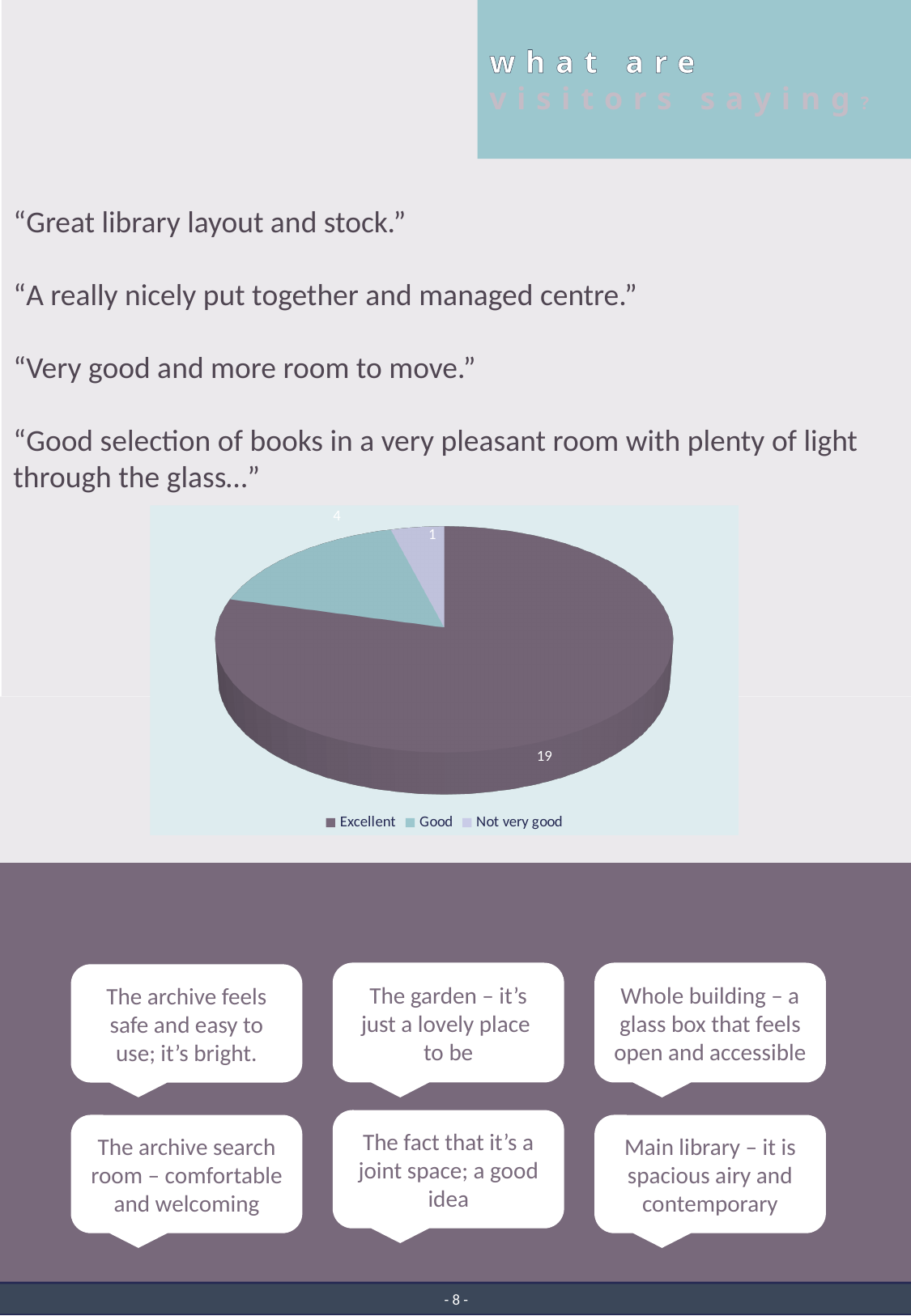
What is the value for the Excellent slice of the pie chart? 19 How many entries does the pie chart's legend list? 3 Which category has the smallest slice in the pie chart? Not very good How many slices does the pie chart have? 3 What kind of chart is shown on the slide? pie chart Which category has the largest slice in the pie chart? Excellent Which is larger in the pie chart, Good or Not very good? Good What is the value for the Good slice of the pie chart? 4 What is the difference between the Excellent and Good values in the pie chart? 15 What is the value for the Not very good slice of the pie chart? 1 What is the difference between the Good and Not very good values in the pie chart? 3 What is the total of all the values shown in the pie chart? 24